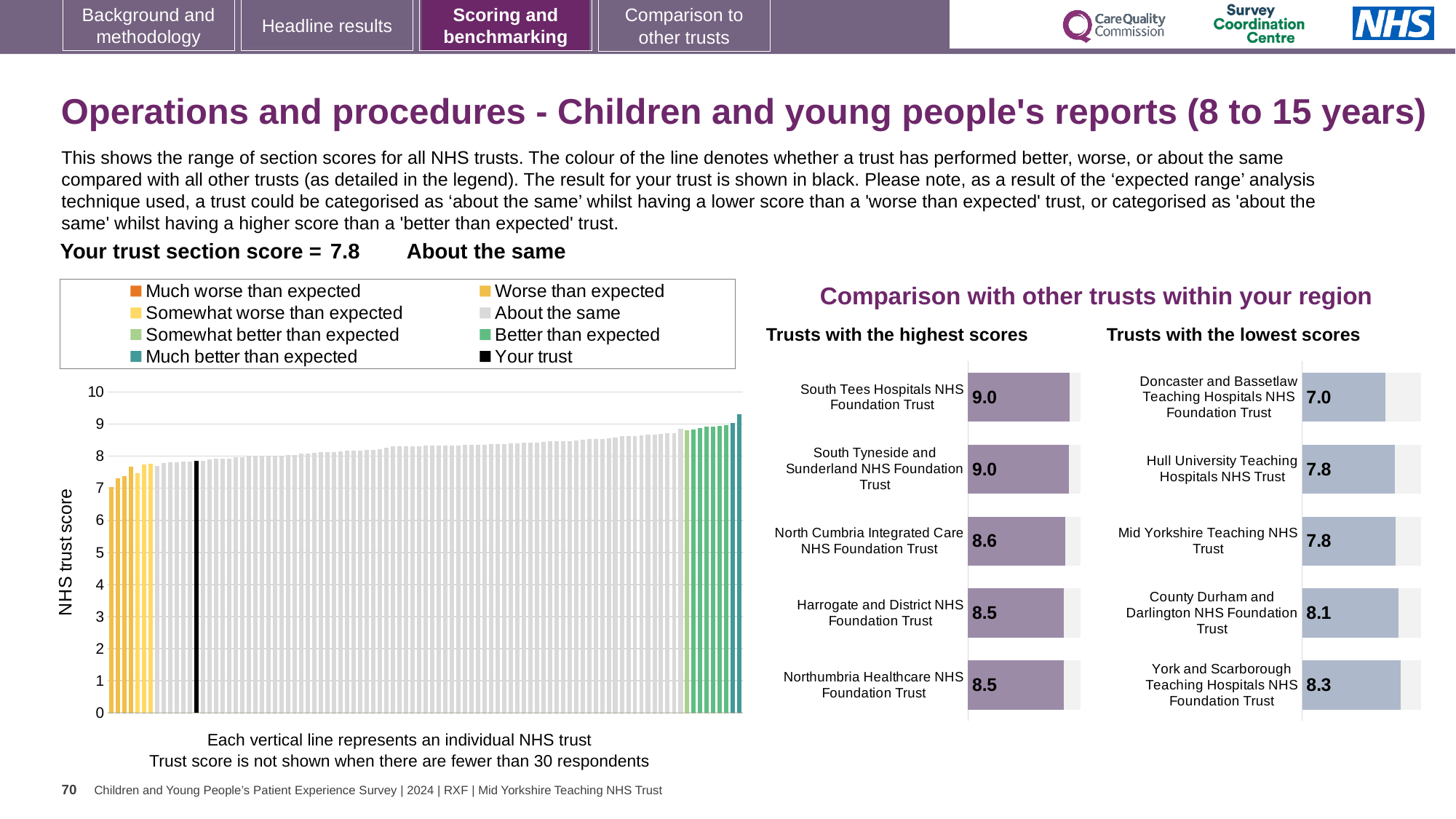
In the 'Trusts with the lowest scores' chart, which trust has the highest score? York and Scarborough Teaching Hospitals NHS Foundation Trust In the large chart on the left, is the value of the black 'Your trust' bar greater or less than 7? greater In the 'Trusts with the highest scores' chart, what is the score for North Cumbria Integrated Care NHS Foundation Trust? 8.6 What kind of chart is the large chart on the left with the y axis labelled 'NHS trust score'? bar chart In the 'Trusts with the highest scores' chart, how many trusts are shown? 5 In the large chart on the left, how many entries does the legend list? 8 In the large chart on the left, is the value of the tallest bar greater or less than 9? greater In the large chart on the left, do the bar heights rise or fall from left to right? rise In the 'Trusts with the lowest scores' chart, what is the difference between the scores of York and Scarborough Teaching Hospitals NHS Foundation Trust and Doncaster and Bassetlaw Teaching Hospitals NHS Foundation Trust? 1.3 In the 'Trusts with the highest scores' chart, what is the difference between the scores of South Tees Hospitals NHS Foundation Trust and North Cumbria Integrated Care NHS Foundation Trust? 0.4 In the 'Trusts with the lowest scores' chart, what is the score for County Durham and Darlington NHS Foundation Trust? 8.1 In the 'Trusts with the lowest scores' chart, which trust has the lowest score? Doncaster and Bassetlaw Teaching Hospitals NHS Foundation Trust